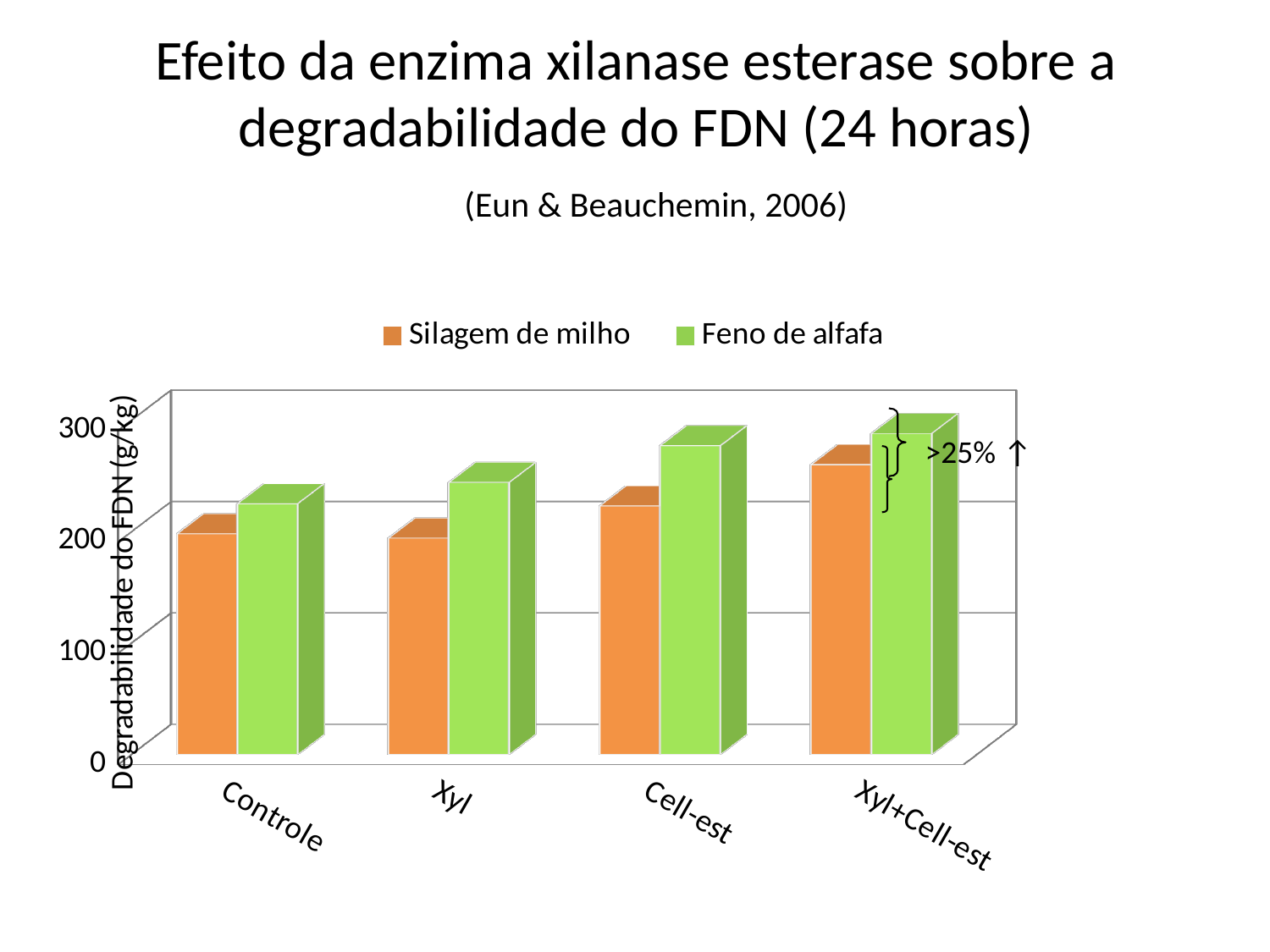
What kind of chart is shown on the slide? bar chart What is the label of the vertical axis? Degradabilidade do FDN (g/kg) For which category is the Silagem de milho value highest? Xyl+Cell-est For Cell-est, which series has the larger value, Silagem de milho or Feno de alfafa? Feno de alfafa Is the Feno de alfafa value for Controle greater or less than 200? greater Is the Silagem de milho value for Controle greater or less than 300? less Do the Feno de alfafa values rise or fall from Controle to Xyl+Cell-est? rise Is the Silagem de milho value for Xyl+Cell-est greater or less than 200? greater Which series are listed in the legend? Silagem de milho and Feno de alfafa How many series does the legend list? 2 How many categories are shown on the x axis? 4 For which category is the Feno de alfafa value highest? Xyl+Cell-est